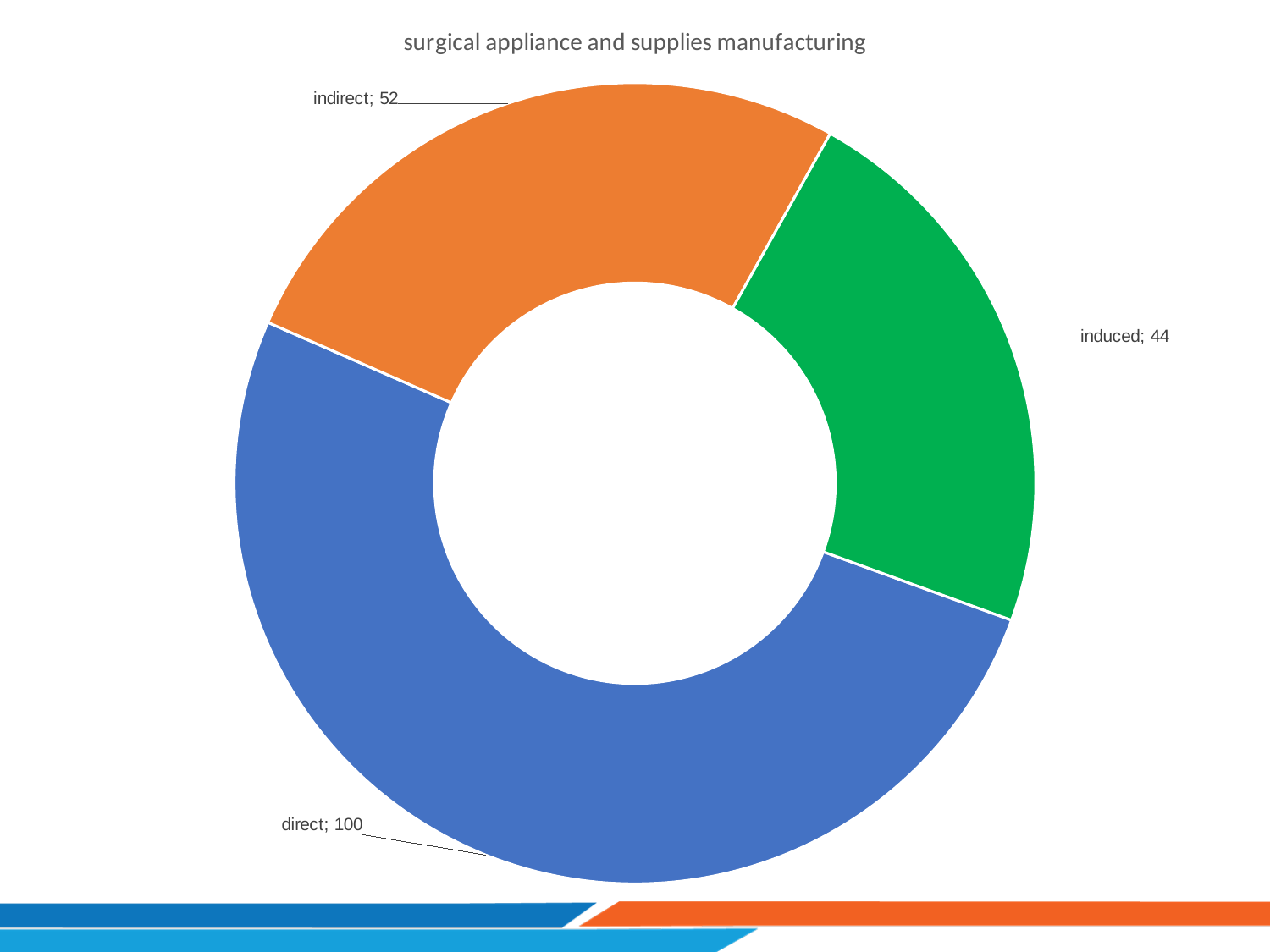
What is the difference between the direct and indirect values? 48 What is the value for the indirect slice? 52 What is the difference between the indirect and induced values? 8 How many slices does the chart have? 3 What is the title of the chart? surgical appliance and supplies manufacturing What is the total of all three slices? 196 Which category has the smallest value? induced What is the value for the induced slice? 44 Which category has the largest value? direct Which is larger, the indirect value or the induced value? indirect What kind of chart is shown on the slide? doughnut chart What is the value for the direct slice? 100